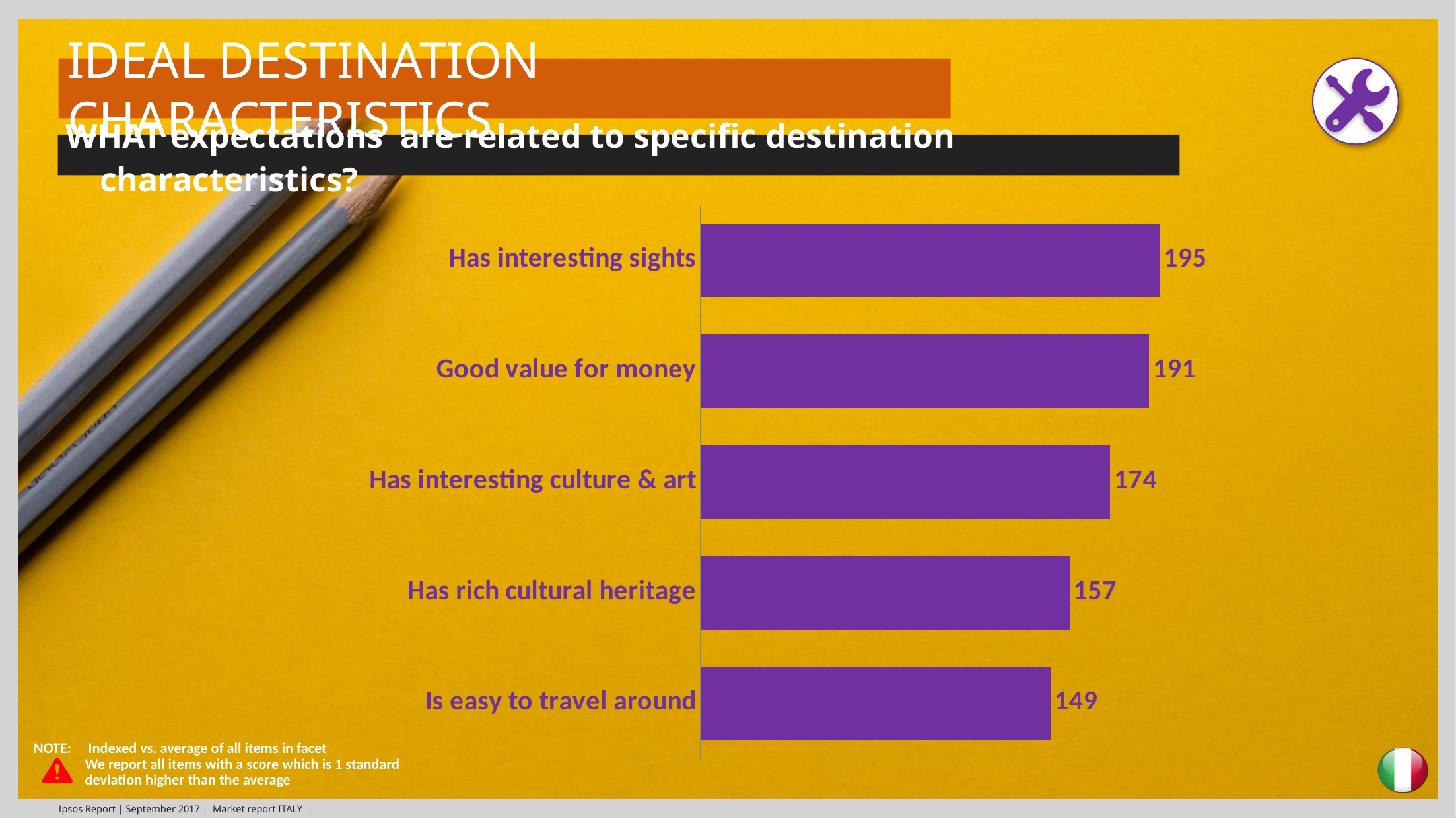
What is the difference between the values for "Has interesting culture & art" and "Has rich cultural heritage"? 17 Which is larger, the value for "Good value for money" or the value for "Has rich cultural heritage"? Good value for money Which category has the lowest value? Is easy to travel around What is the value for "Has rich cultural heritage"? 157 What is the value for "Has interesting sights"? 195 Which category has the highest value? Has interesting sights What is the value for "Good value for money"? 191 What kind of chart is shown on the slide? Bar chart What is the value for "Is easy to travel around"? 149 What is the difference between the values for "Has interesting sights" and "Is easy to travel around"? 46 How many categories are shown in the chart? 5 What is the value for "Has interesting culture & art"? 174